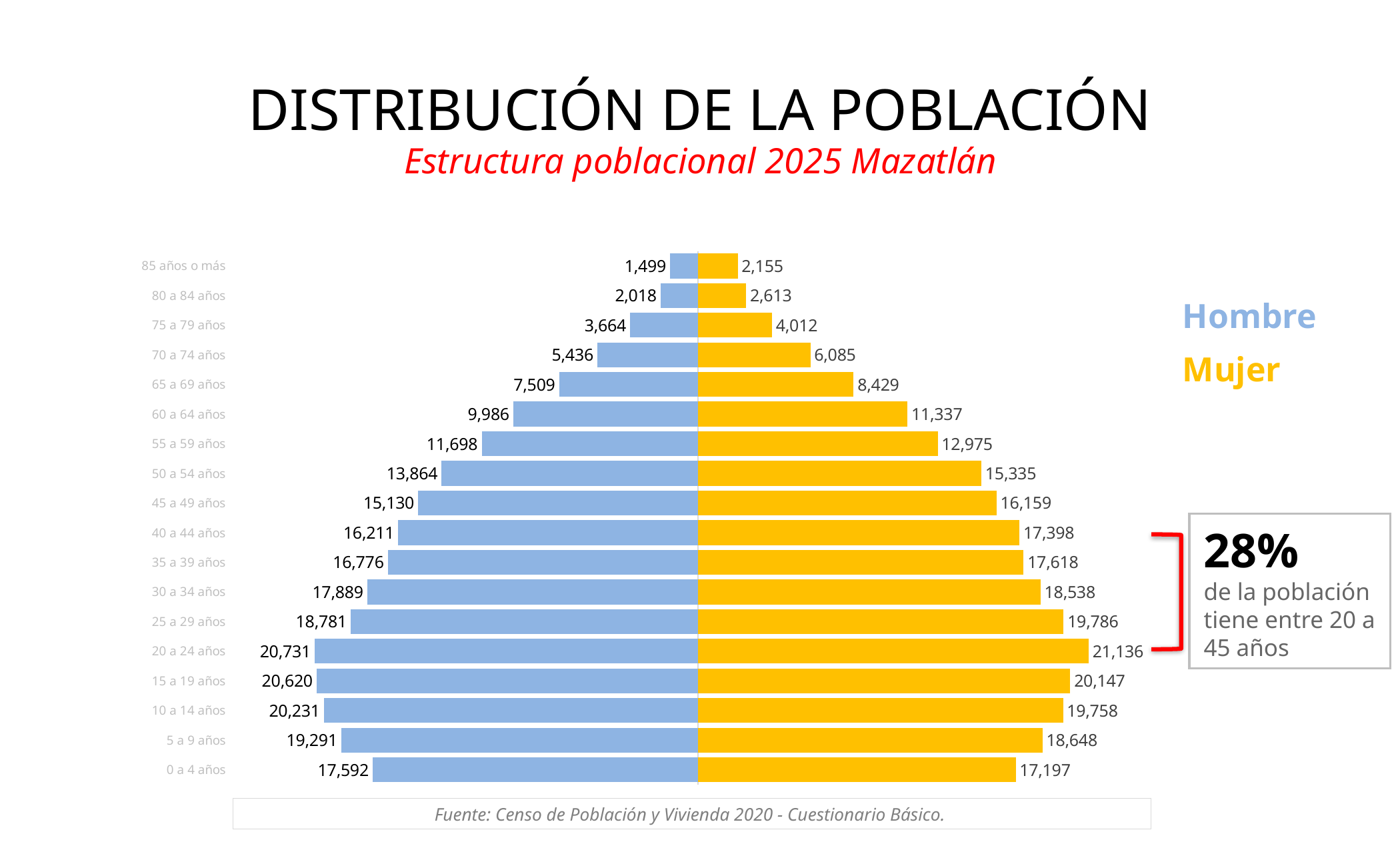
What is the Mujer value for the 65 a 69 años age group? 8,429 Which age group has the highest Mujer value? 20 a 24 años For the 0 a 4 años age group, which is larger, the Hombre value or the Mujer value? Hombre For the 60 a 64 años age group, which is larger, the Hombre value or the Mujer value? Mujer What kind of chart is shown on the slide? Bar chart (population pyramid) Which colour represents the Mujer series? Yellow What is the difference between the Mujer and Hombre values for the 20 a 24 años age group? 405 How many series does the legend list? 2 Which age group has the lowest Hombre value? 85 años o más What is the Hombre value for the 20 a 24 años age group? 20,731 How many age groups are shown in the chart? 18 What is the Hombre value for the 85 años o más age group? 1,499